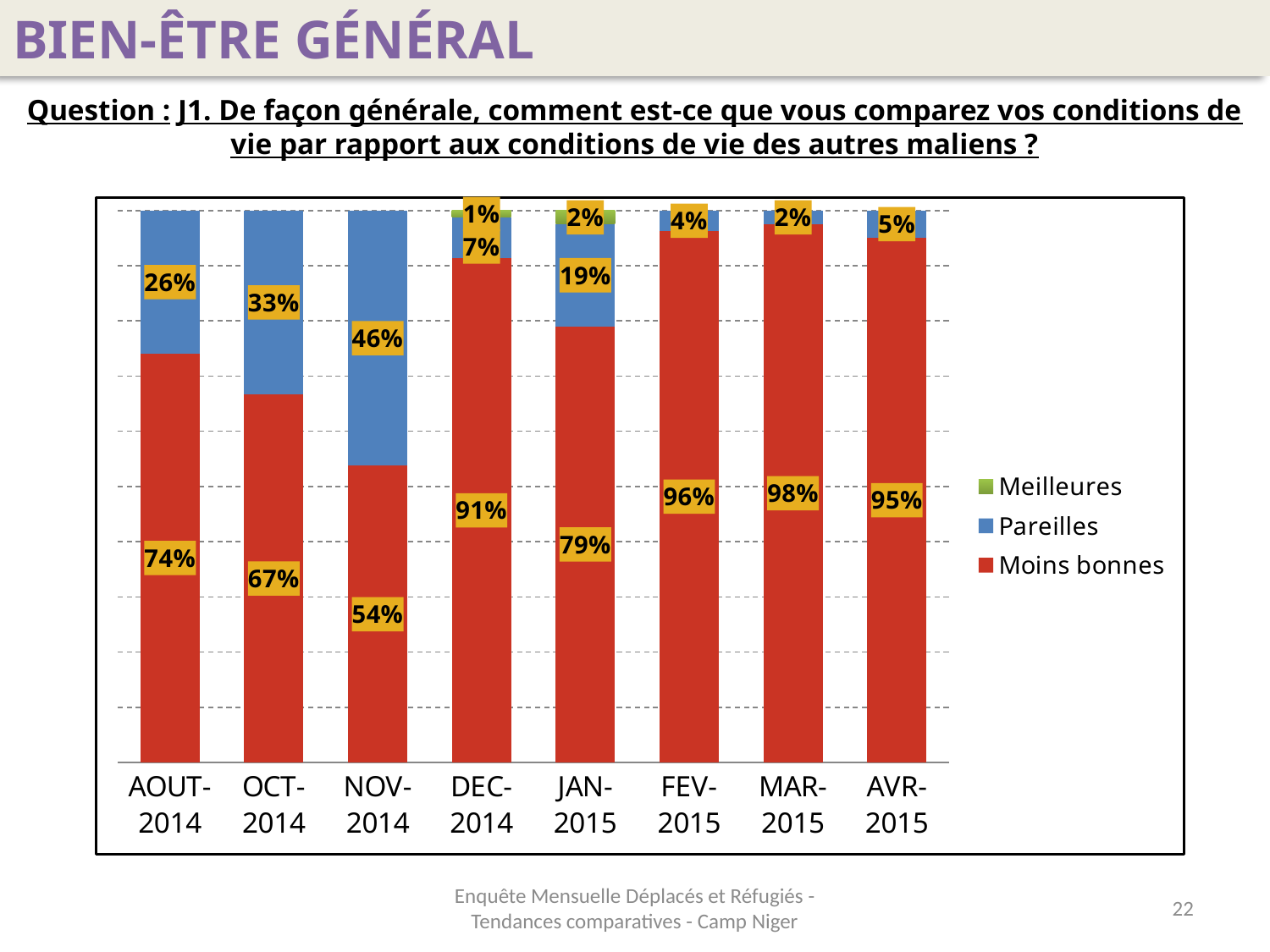
What type of chart is shown on the slide? stacked bar chart Does the 'Moins bonnes' value rise or fall from NOV-2014 to DEC-2014? rise Which series is shown in red? Moins bonnes How many series does the legend list? 3 What is the value for 'Moins bonnes' in NOV-2014? 54% What is the value for 'Meilleures' in DEC-2014? 1% What is the value for 'Pareilles' in JAN-2015? 19% In which month is the 'Moins bonnes' value highest? MAR-2015 Which is larger: the 'Pareilles' value in AOUT-2014 or in OCT-2014? OCT-2014 How many months (categories) are shown on the x axis? 8 What is the difference between the 'Moins bonnes' values for AOUT-2014 and OCT-2014? 7% In which month is the 'Pareilles' value highest? NOV-2014